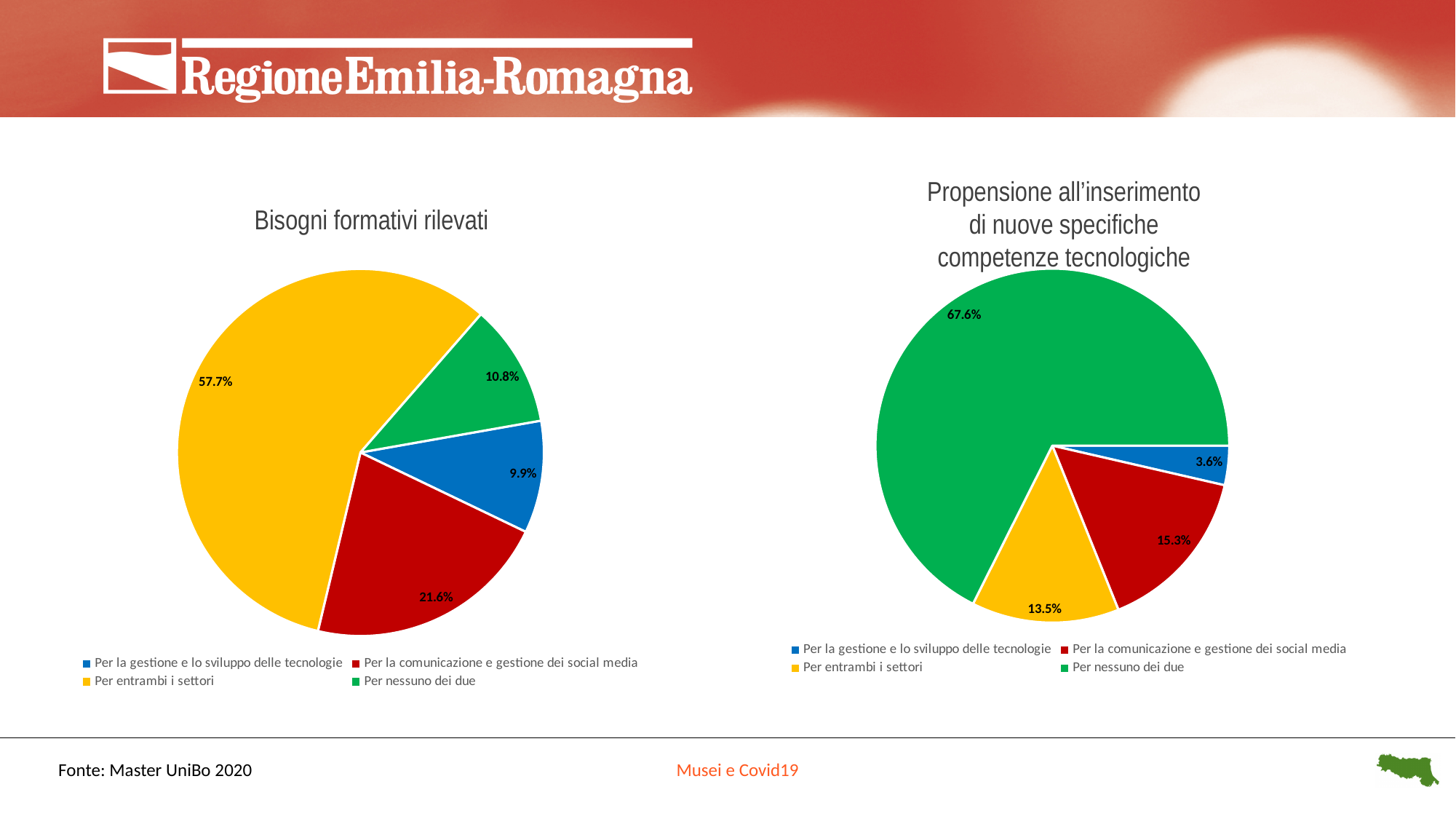
In the 'Propensione all'inserimento di nuove specifiche competenze tecnologiche' chart, what is the share for 'Per nessuno dei due'? 67.6% In the 'Bisogni formativi rilevati' chart, what is the share for 'Per la comunicazione e gestione dei social media'? 21.6% How many slices does the 'Bisogni formativi rilevati' chart have? 4 In the 'Bisogni formativi rilevati' chart, which is larger: 'Per nessuno dei due' or 'Per la gestione e lo sviluppo delle tecnologie'? Per nessuno dei due In the 'Bisogni formativi rilevati' chart, what is the share for 'Per entrambi i settori'? 57.7% In the 'Bisogni formativi rilevati' chart, which category has the smallest slice? Per la gestione e lo sviluppo delle tecnologie In the 'Propensione all'inserimento di nuove specifiche competenze tecnologiche' chart, which category has the largest slice? Per nessuno dei due In the 'Propensione all'inserimento di nuove specifiche competenze tecnologiche' chart, what is the difference between 'Per la comunicazione e gestione dei social media' and 'Per entrambi i settori'? 1.8% In the 'Bisogni formativi rilevati' chart, what is the difference between 'Per entrambi i settori' and 'Per la comunicazione e gestione dei social media'? 36.1% In the 'Propensione all'inserimento di nuove specifiche competenze tecnologiche' chart, what is the share for 'Per la gestione e lo sviluppo delle tecnologie'? 3.6% In the 'Bisogni formativi rilevati' chart, what colour is the 'Per entrambi i settori' slice? Yellow What type of chart is the 'Propensione all'inserimento di nuove specifiche competenze tecnologiche' chart? Pie chart